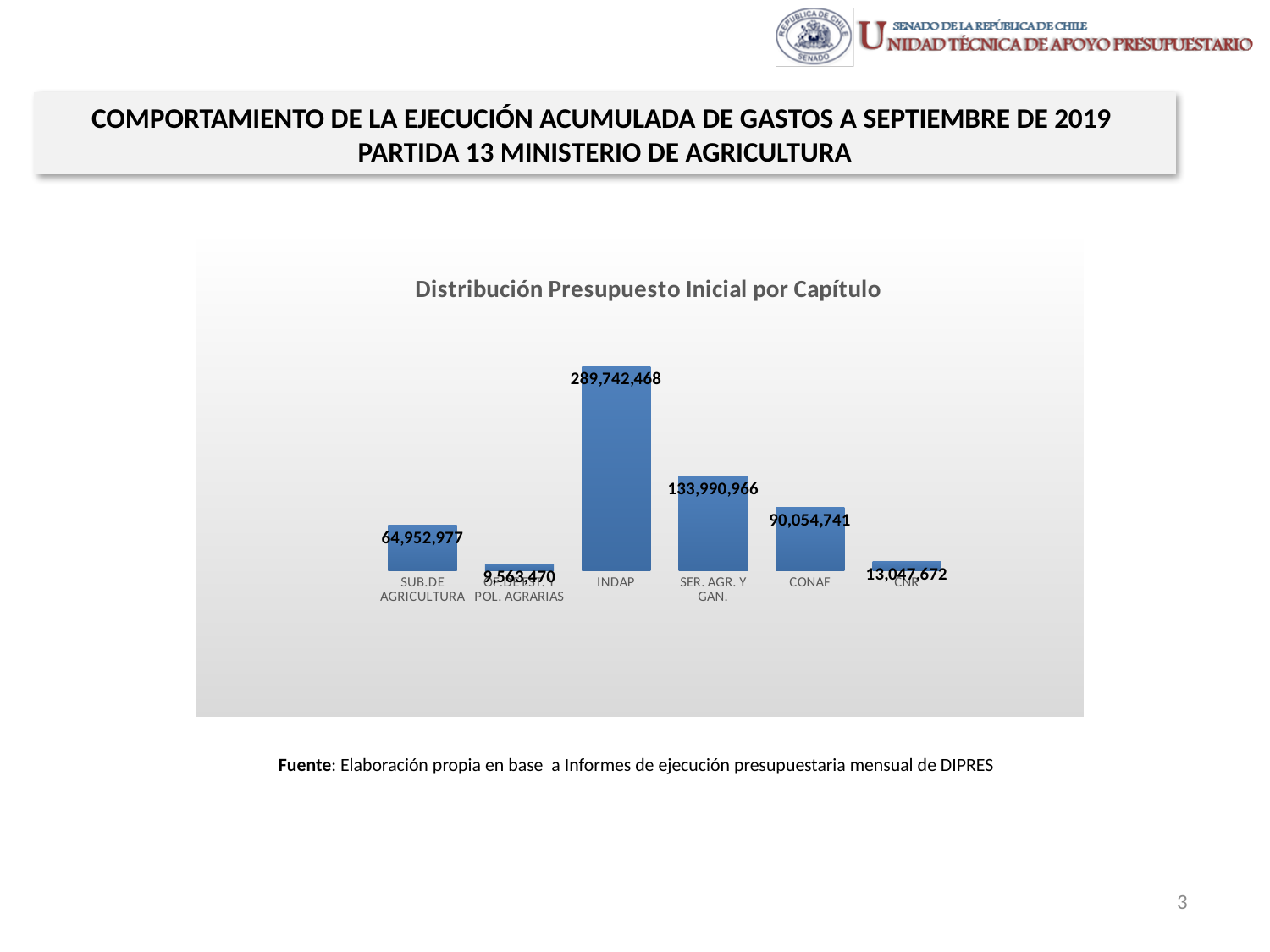
How many categories are shown in the chart? 6 What is the difference between the values for CONAF and SUB.DE AGRICULTURA? 25,101,764 What is the value for CONAF? 90,054,741 Which category has the highest value? INDAP Which category has the lowest value? OF.DE EST. Y POL. AGRARIAS What is the difference between the values for INDAP and SER. AGR. Y GAN.? 155,751,502 What is the value for SER. AGR. Y GAN.? 133,990,966 What is the value for SUB.DE AGRICULTURA? 64,952,977 What type of chart is shown on the slide? Bar chart What is the value for CNR? 13,047,672 What is the value for INDAP in the Distribución Presupuesto Inicial por Capítulo chart? 289,742,468 Which is larger, the value for CONAF or the value for SER. AGR. Y GAN.? SER. AGR. Y GAN.